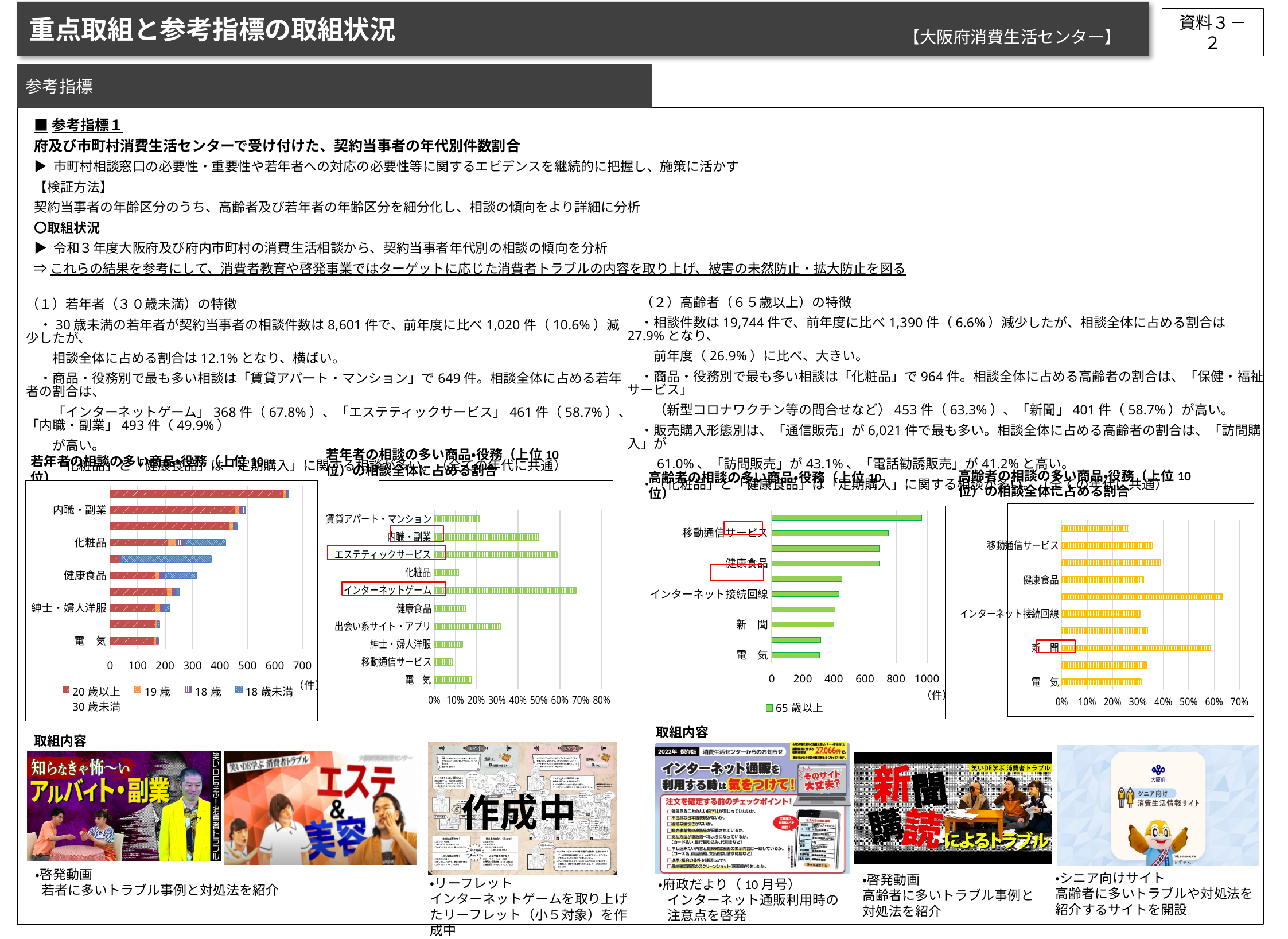
In the chart titled 高齢者の相談の多い商品・役務（上位10位）, which is larger, 移動通信サービス or 電気? 移動通信サービス In the chart titled 高齢者の相談の多い商品・役務（上位10位）の相談全体に占める割合, is the value for 新聞 greater or less than 50%? greater In the stacked bar chart titled 若年者の相談の多い商品・役務（上位10位）, how many series does the legend list? 4 In the chart titled 若年者の相談の多い商品・役務（上位10位）の相談全体に占める割合, how many categories are plotted? 10 In the chart titled 若年者の相談の多い商品・役務（上位10位）の相談全体に占める割合, what kind of chart is shown? bar chart In the chart titled 若年者の相談の多い商品・役務（上位10位）の相談全体に占める割合, is the value for 賃貸アパート・マンション greater or less than 30%? less In the chart titled 高齢者の相談の多い商品・役務（上位10位）, what series does the legend list? 65歳以上 In the chart titled 若年者の相談の多い商品・役務（上位10位）の相談全体に占める割合, which category has the highest value? インターネットゲーム In the chart titled 若年者の相談の多い商品・役務（上位10位）の相談全体に占める割合, which is larger, 内職・副業 or 化粧品? 内職・副業 In the chart titled 若年者の相談の多い商品・役務（上位10位）の相談全体に占める割合, is the value for 内職・副業 greater or less than 40%? greater